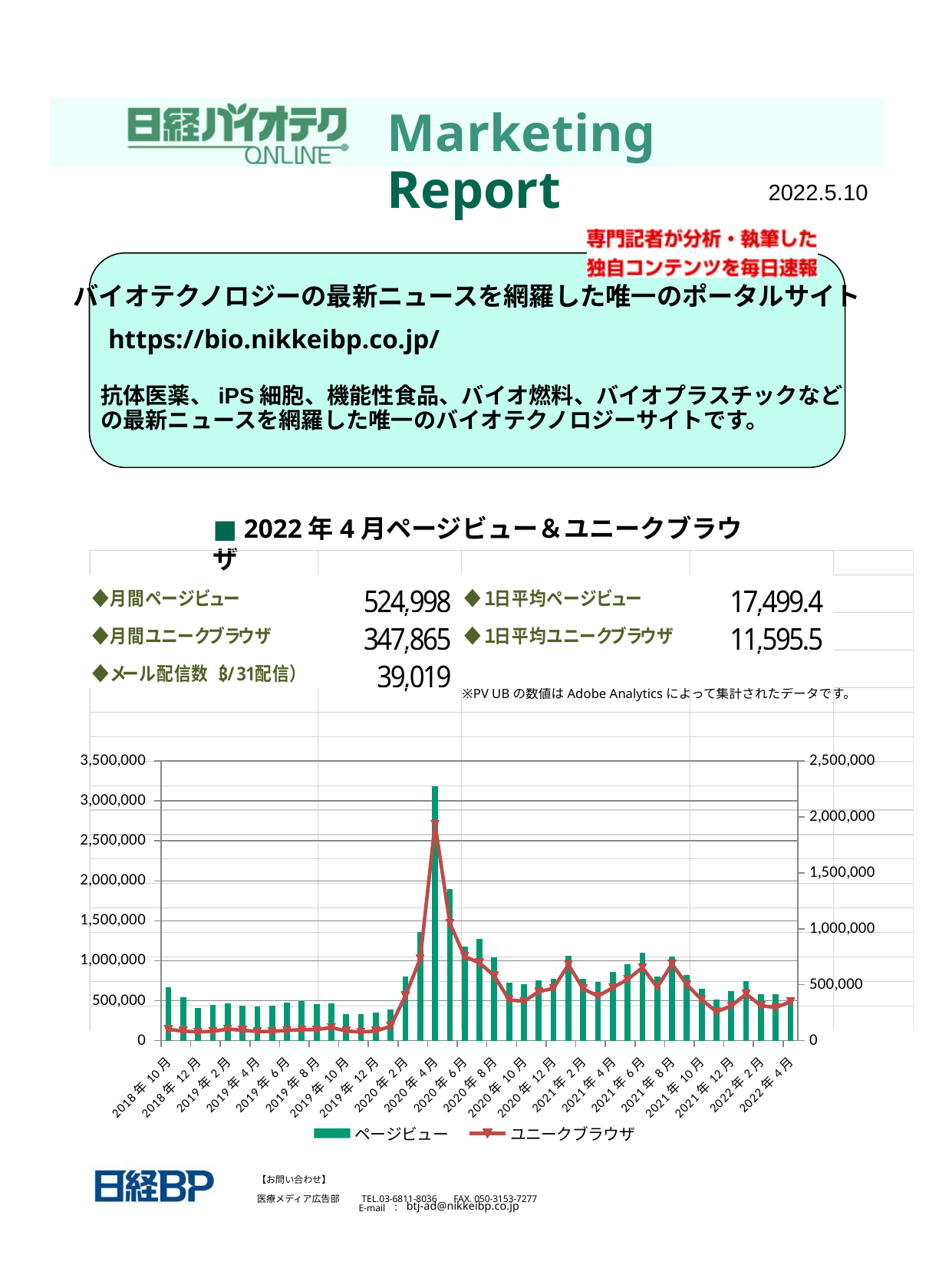
What is the monthly page view figure (月間ページビュー) printed for April 2022? 524,998 Is the page view value for 2020年4月 greater or less than 3,000,000? greater In which month do the page views (ページビュー) bars reach their highest value? 2020年4月 Do page views rise or fall from 2020年4月 to 2020年10月? fall What is the maximum value shown on the left vertical axis of the chart? 3,500,000 Which series is drawn as bars and which as a line in the chart? ページビュー is bars; ユニークブラウザ is a line Is the unique browser (ユニークブラウザ) value for 2020年4月 greater or less than 1,500,000 on the right axis? greater Is the page view value for 2018年10月 greater or less than 1,000,000? less Which month has higher page views, 2020年4月 or 2021年2月? 2020年4月 What kind of chart is shown on the slide? A combination bar and line chart How many series does the chart legend list? 2